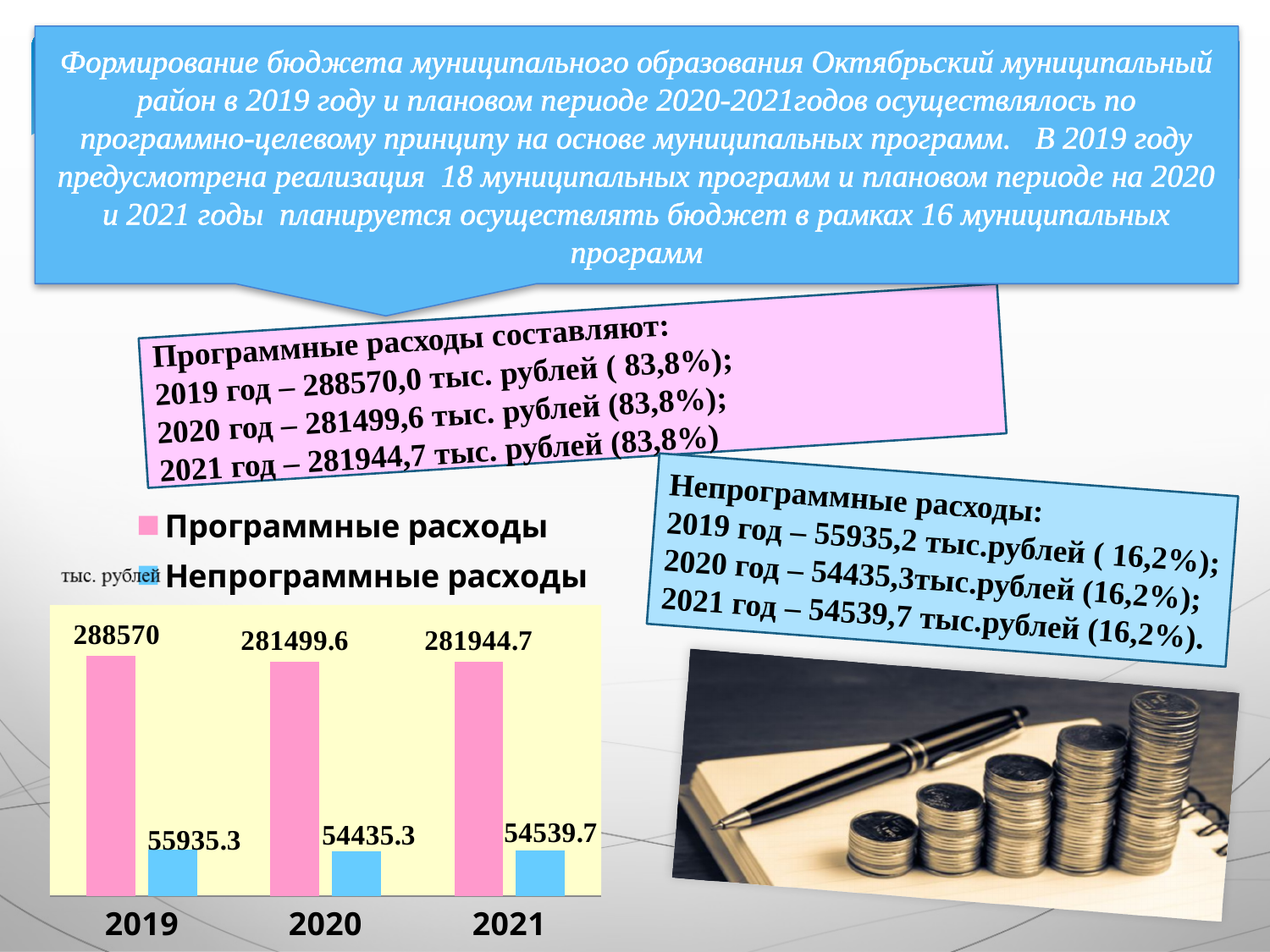
What is the value of Программные расходы for 2020? 281499.6 How many years are shown on the x axis of the chart? 3 In which year is Непрограммные расходы lowest? 2020 Which is larger in 2020: Программные расходы or Непрограммные расходы? Программные расходы What is the difference between Программные расходы and Непрограммные расходы in 2021? 227405 What type of chart is shown on the slide? bar chart How many series does the chart legend list? 2 What is the value of Непрограммные расходы for 2021? 54539.7 Which colour represents Непрограммные расходы in the chart? blue What is the value of Непрограммные расходы for 2019 as labelled on the chart? 55935.3 In which year is Программные расходы highest? 2019 What is the value of Программные расходы for 2019? 288570